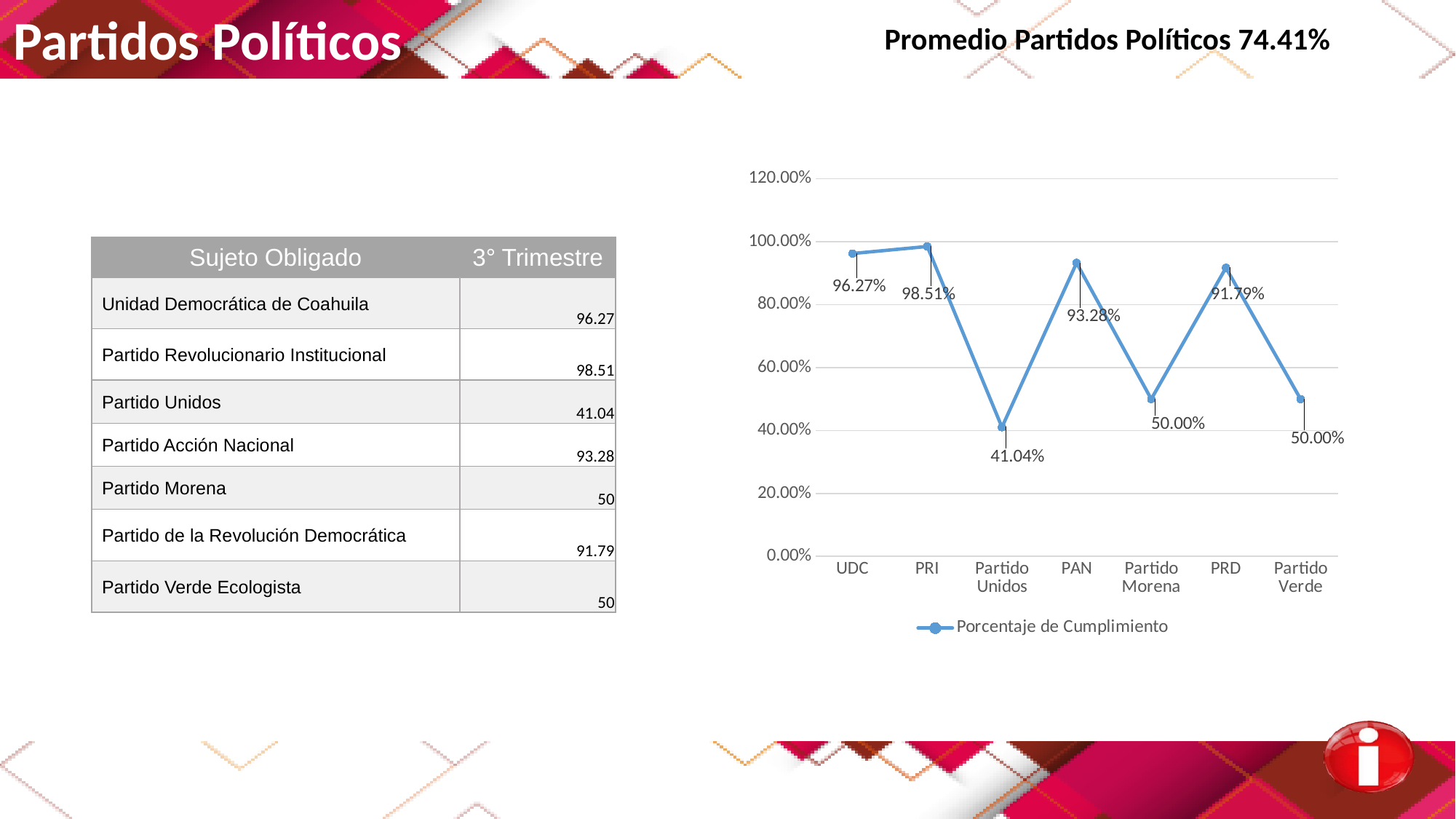
What kind of chart is shown on the slide? line chart How many categories are plotted on the x axis of the chart? 7 Which category has the highest value in the chart? PRI How many series does the chart legend list? 1 Which is larger, the value for UDC or the value for PRD? UDC What is the value for PRI in the chart? 98.51% Which category has the lowest value in the chart? Partido Unidos What is the difference between the values for PRI and Partido Unidos? 57.47% What is the name of the series shown in the chart legend? Porcentaje de Cumplimiento What is the value for PAN in the chart? 93.28% Is the value for Partido Morena greater or less than 60.00%? less What is the value for Partido Unidos in the chart? 41.04%